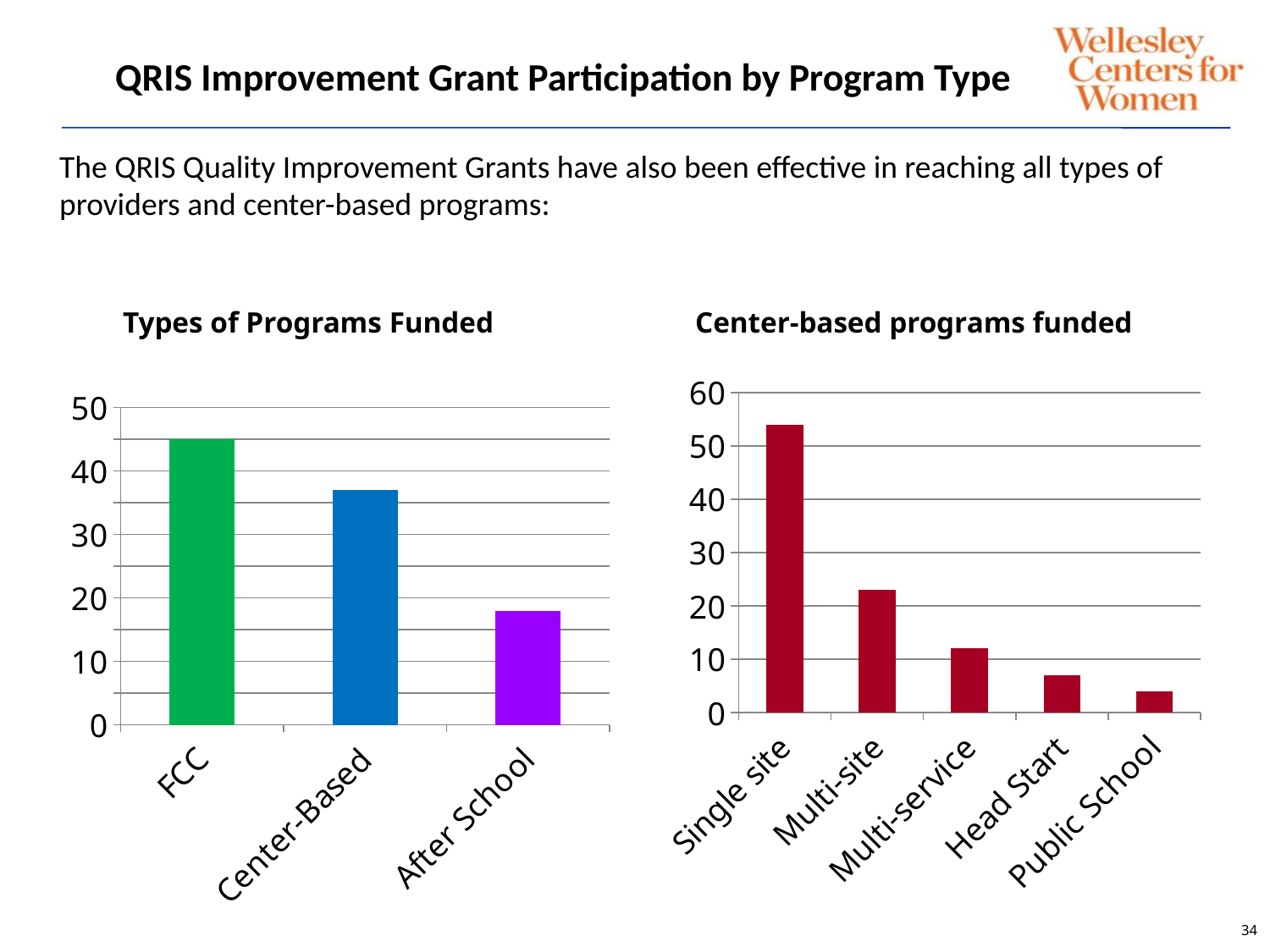
What kind of chart is the 'Center-based programs funded' chart? Bar chart In the 'Center-based programs funded' chart, which is larger, Multi-service or Head Start? Multi-service In the 'Types of Programs Funded' chart, which category has the highest value? FCC In the 'Types of Programs Funded' chart, how many categories are shown? 3 In the 'Center-based programs funded' chart, which category has the highest value? Single site In the 'Types of Programs Funded' chart, which category has the lowest value? After School In the 'Center-based programs funded' chart, is the value for Multi-site greater or less than 30? less In the 'Types of Programs Funded' chart, is the value for FCC greater or less than 40? greater In the 'Types of Programs Funded' chart, is the value for After School greater or less than 20? less In the 'Center-based programs funded' chart, how many categories are shown? 5 In the 'Center-based programs funded' chart, which category has the lowest value? Public School